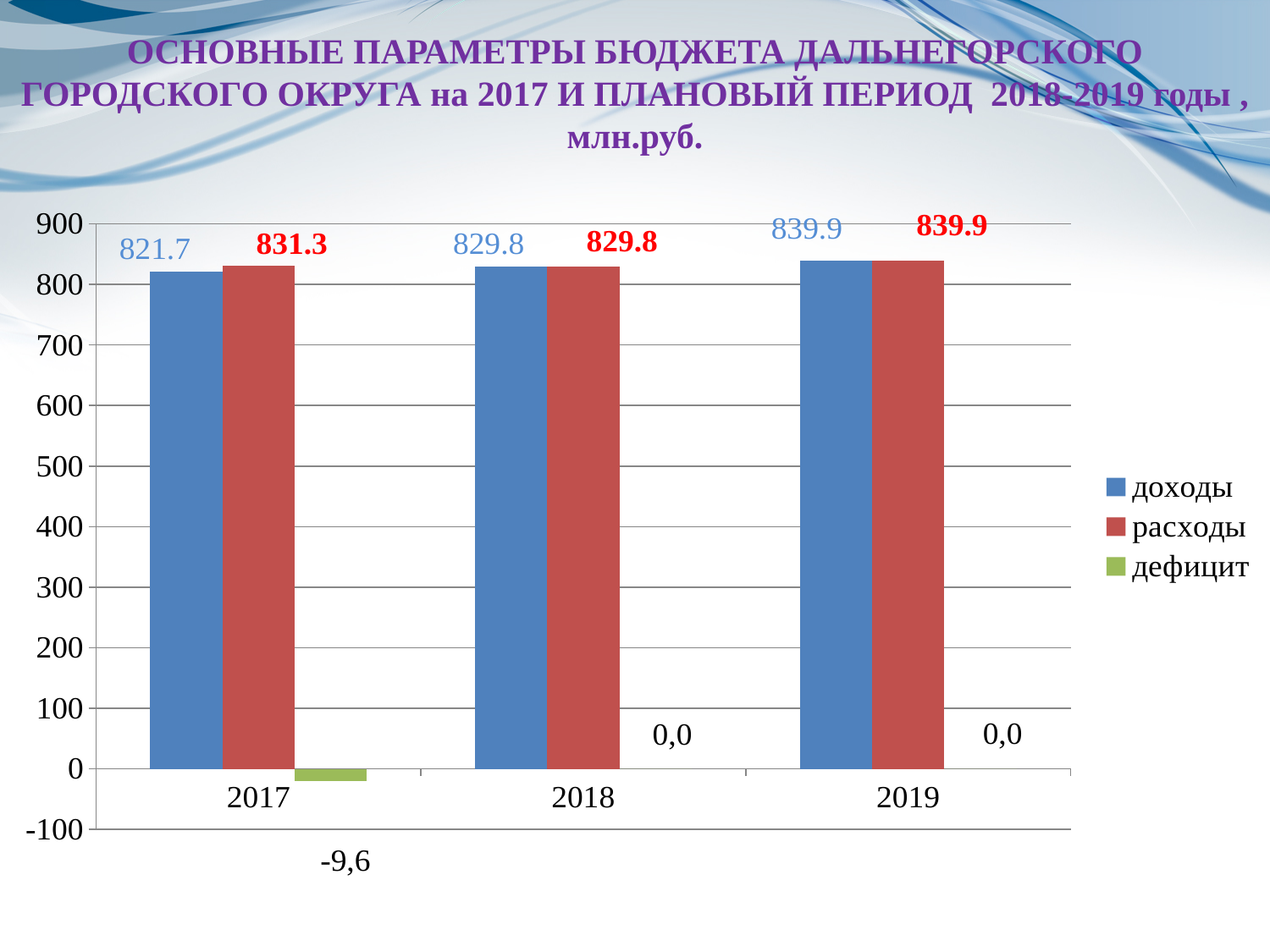
What kind of chart is shown on the slide? bar chart What is the difference between расходы and доходы in 2017? 9.6 What is the value of дефицит for 2018? 0,0 What is the difference between доходы in 2019 and доходы in 2017? 18.2 In which year is доходы lowest? 2017 What is the value of дефицит for 2017? -9,6 What is the value of расходы for 2017? 831.3 What is the value of расходы for 2019? 839.9 Do the values of доходы rise or fall from 2017 to 2019? rise How many series does the legend list? 3 What is the value of доходы for 2017? 821.7 In which year is доходы highest? 2019